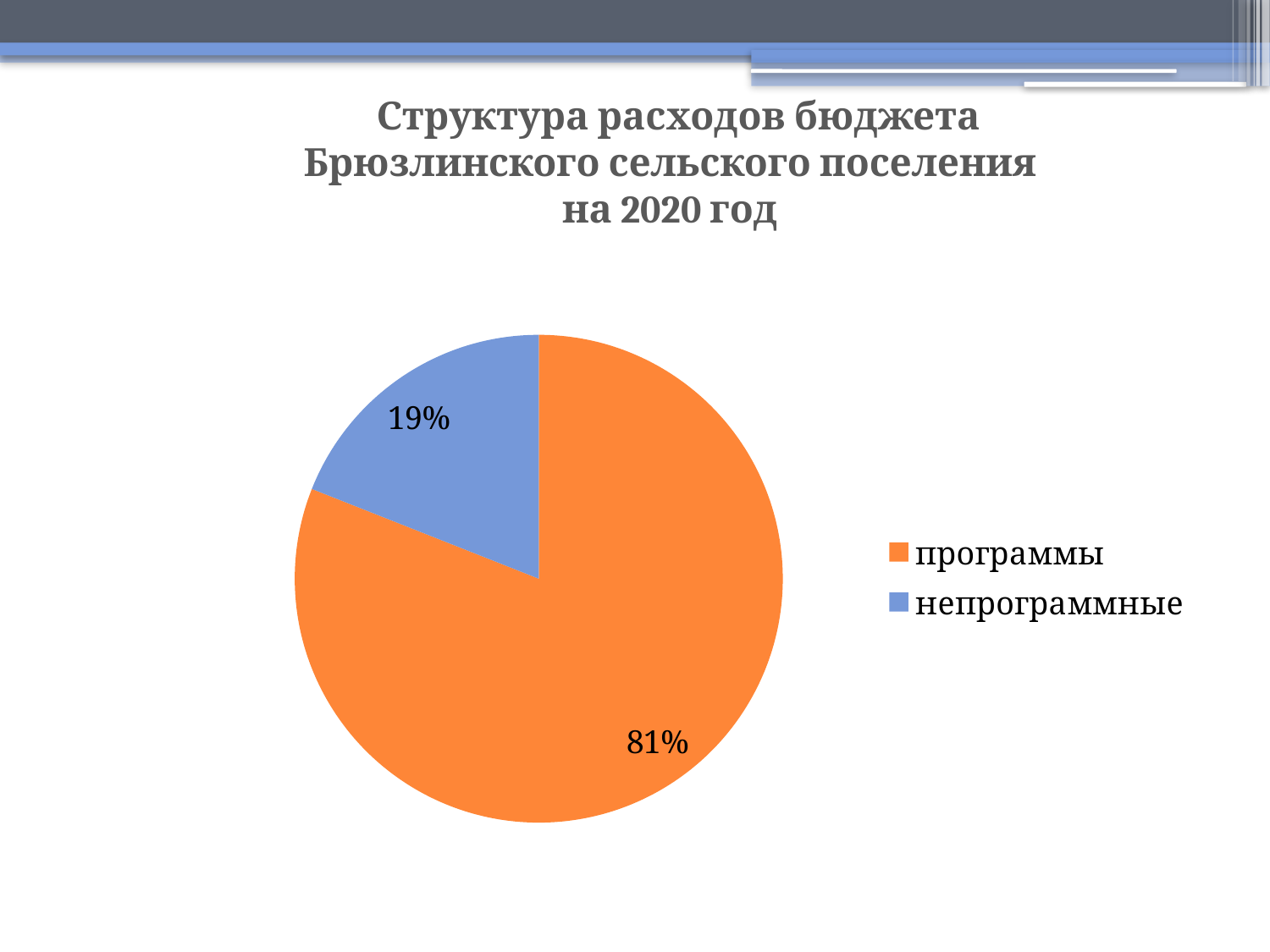
Which category has the largest slice of the pie? программы How many entries does the legend list? 2 Which category has the smallest slice of the pie? непрограммные What kind of chart is shown on the slide? pie chart What share of the pie does the "непрограммные" slice represent? 19% What is the title of the chart on the slide? Структура расходов бюджета Брюзлинского сельского поселения на 2020 год What is the difference in percentage points between the "программы" and "непрограммные" slices? 62 What colour is the "непрограммные" slice? blue Which is larger, the "программы" slice or the "непрограммные" slice? программы How many slices does the pie chart have? 2 What share of the pie does the "программы" slice represent? 81%